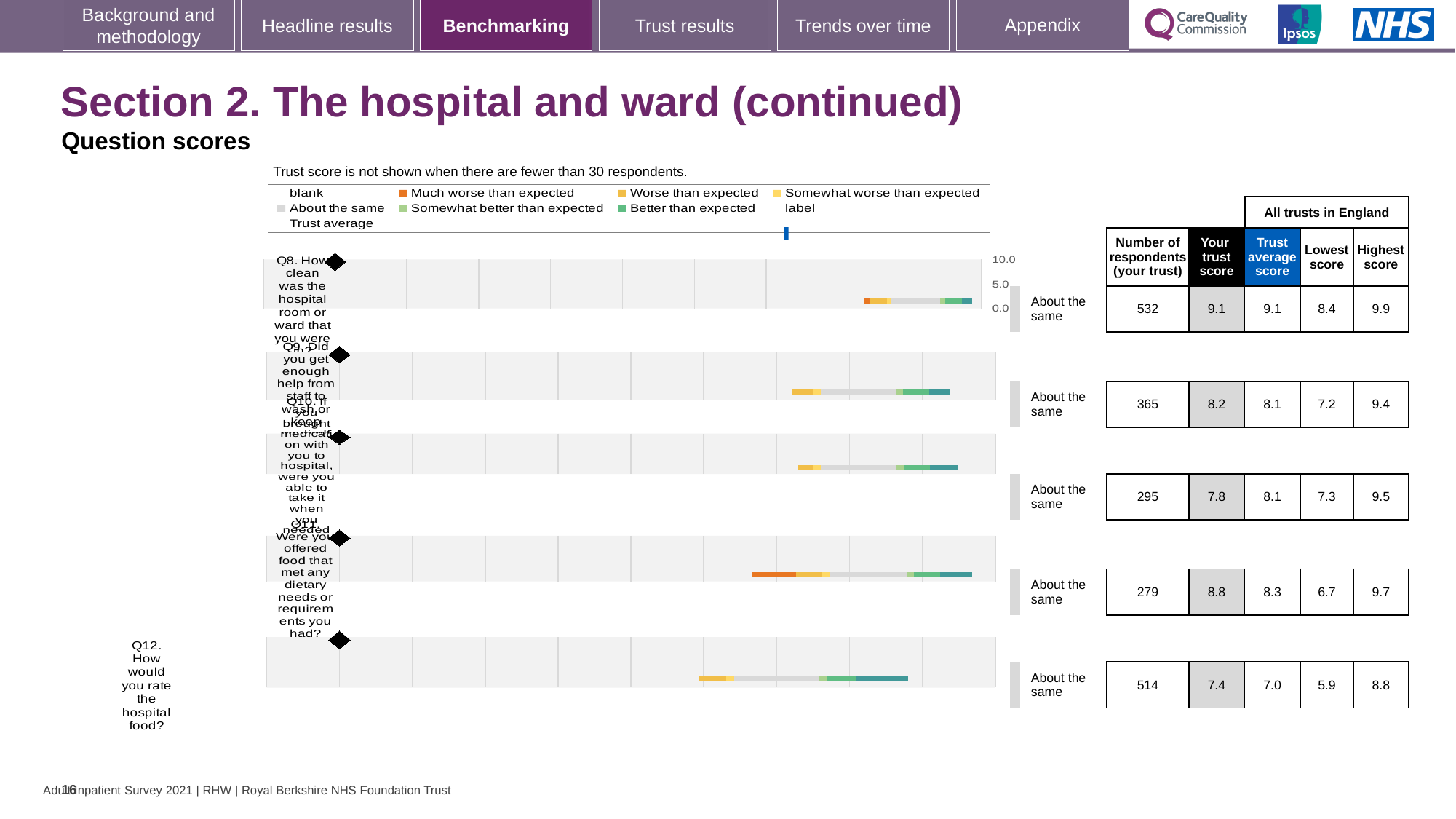
Which question has the highest 'Your trust score'? Q8 What colour does the legend use for 'Much worse than expected'? Orange What benchmark category is shown for Q12? About the same What is the trust score for Q8 (How clean was the hospital room or ward that you were in?)? 9.1 For Q10, which is larger: the trust score or the trust average score? Trust average score Which question has the lowest 'Your trust score'? Q12 What kind of chart is used to show the question scores on this slide? Bar chart What is the trust average score for Q12 (How would you rate the hospital food?)? 7.0 How many respondents answered Q9 for this trust? 365 For Q11, how much higher is the trust score (8.8) than the trust average score (8.3)? 0.5 What is the highest score across all trusts in England for Q11? 9.7 How many questions (Q8 to Q12) are plotted in the question scores chart? 5